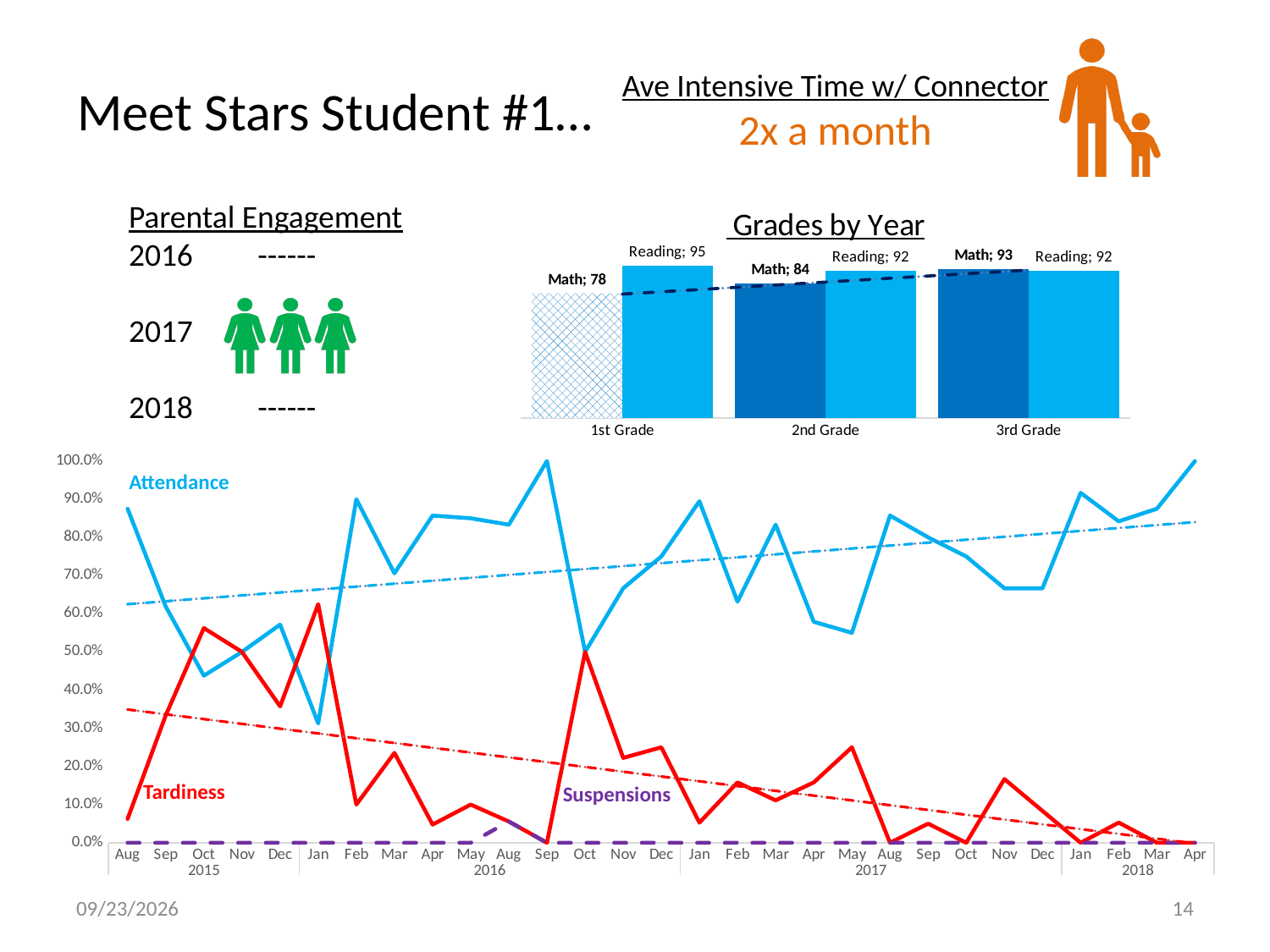
In the Grades by Year chart, which grade has the highest Math value? 3rd Grade In the Grades by Year chart, how many grade categories are shown? 3 In the Grades by Year chart, what is the Reading value for 1st Grade? 95 In the bottom line chart, is the Attendance value for Jan 2016 greater or less than 40.0%? less In the Grades by Year chart, what is the Math value for 3rd Grade? 93 What kind of chart is the chart at the bottom of the slide showing Attendance, Tardiness and Suspensions? line chart In the Grades by Year chart, what is the Math value for 1st Grade? 78 In the bottom line chart, is the Attendance value for Sep 2016 greater or less than 90.0%? greater In the Grades by Year chart, what is the difference between the Reading and Math values for 1st Grade? 17 In the Grades by Year chart, do the Math values rise or fall from 1st Grade to 3rd Grade? rise In the Grades by Year chart, which is larger for 2nd Grade, Math or Reading? Reading In the Grades by Year chart, which grade has the lowest Math value? 1st Grade